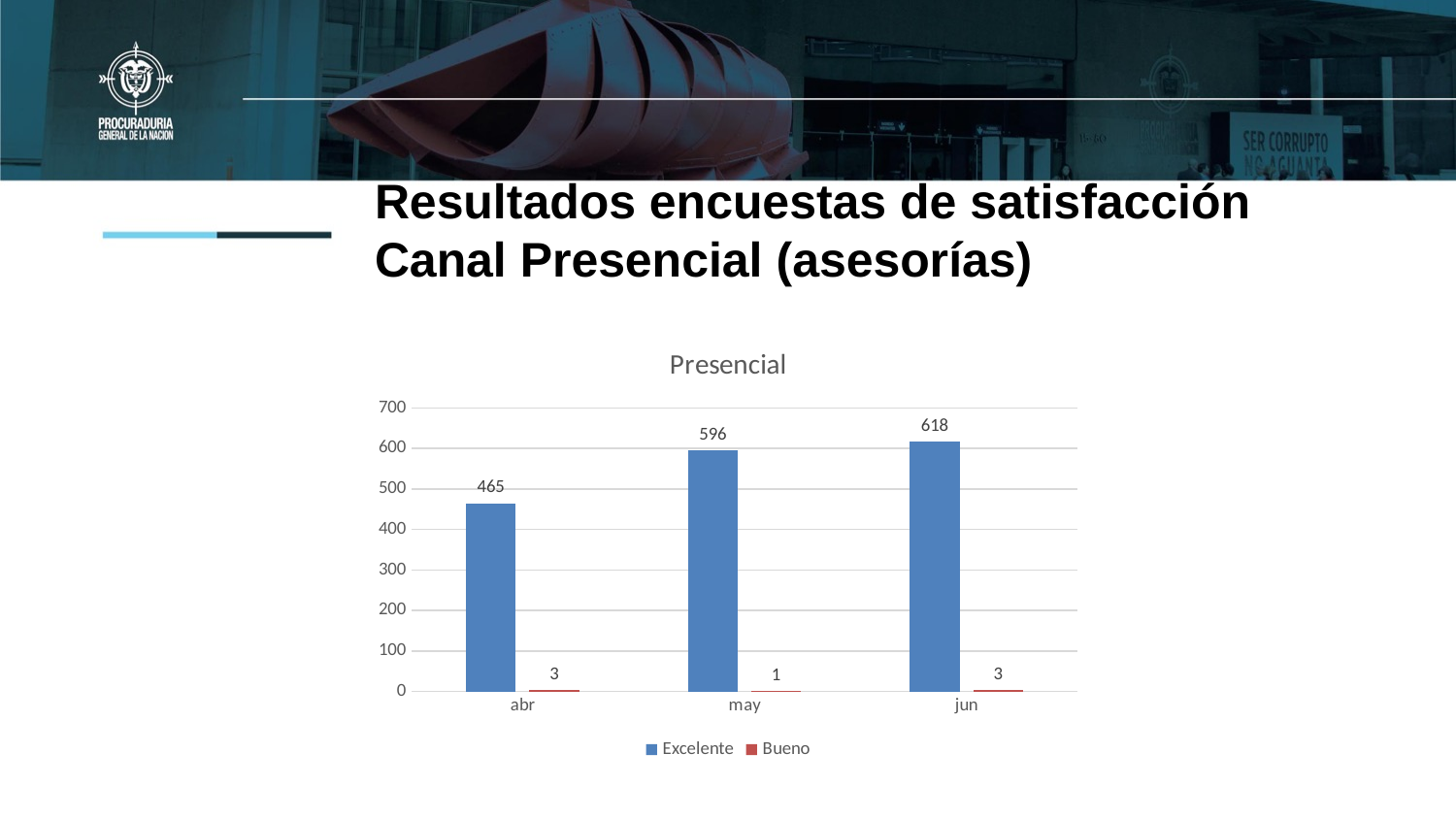
What is the value for Bueno in abr? 3 Do the Excelente values rise or fall from abr to jun? rise What kind of chart is shown? bar chart Which is larger, the Excelente value for may or for abr? may Which month has the highest Excelente value? jun How many months are shown on the x axis? 3 What is the value for Excelente in jun? 618 How many series does the legend list? 2 What is the difference between the Excelente values for jun and abr? 153 Is the value for Excelente in abr greater or less than 500? less What is the value for Excelente in may? 596 Which month has the lowest Excelente value? abr